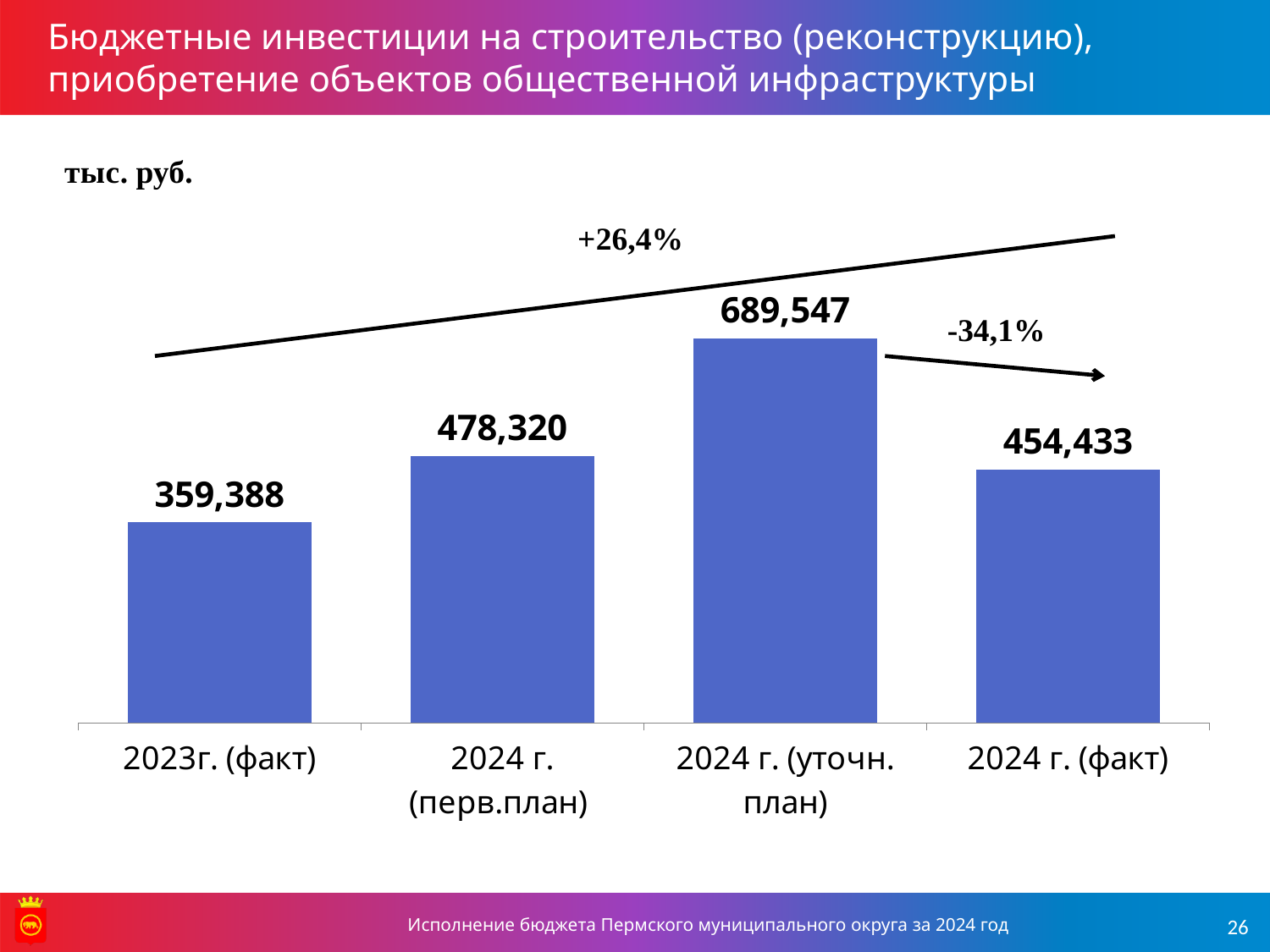
What percentage change is shown by the arrow between 2024 г. (уточн. план) and 2024 г. (факт)? -34,1% What is the value for 2024 г. (уточн. план)? 689,547 What is the difference between the values for 2024 г. (уточн. план) and 2024 г. (факт)? 235,114 Which category has the lowest value? 2023г. (факт) What is the value for 2024 г. (факт)? 454,433 Which category has the highest value? 2024 г. (уточн. план) How many categories are shown on the x axis? 4 What is the difference between the values for 2024 г. (перв.план) and 2023г. (факт)? 118,932 What is the value for 2023г. (факт)? 359,388 What kind of chart is shown on the slide? Bar chart What is the value for 2024 г. (перв.план)? 478,320 Which is larger: the value for 2024 г. (перв.план) or the value for 2024 г. (факт)? 2024 г. (перв.план)